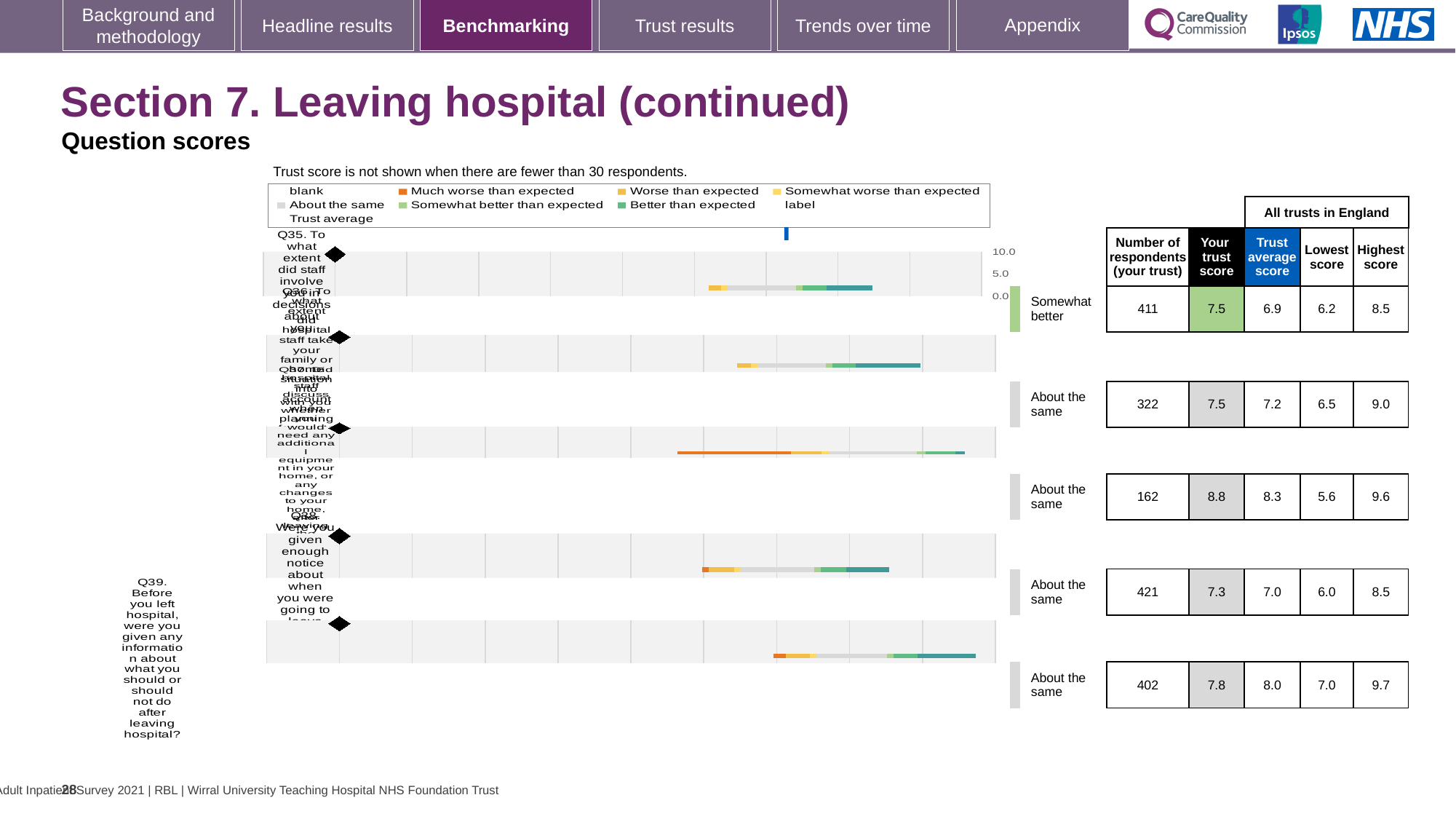
What kind of chart is used to show the question scores? Bar chart Which question has the highest trust score for this trust? Q37 How many questions are plotted on the chart? 5 What is the trust average score for Q36? 7.2 What is the trust score for Q37 (additional equipment or changes to your home)? 8.8 Which question is rated 'Somewhat better' than expected for this trust? Q35 Which question has the fewest respondents at this trust? Q37 For Q39, which is larger: this trust's score or the trust average score? Trust average score What is the highest score across all trusts in England for Q39? 9.7 What is the difference between this trust's score and the trust average score for Q35? 0.6 How many respondents answered Q38 (enough notice about when you were going to leave hospital) at this trust? 421 What is the lowest score across all trusts in England for Q37? 5.6